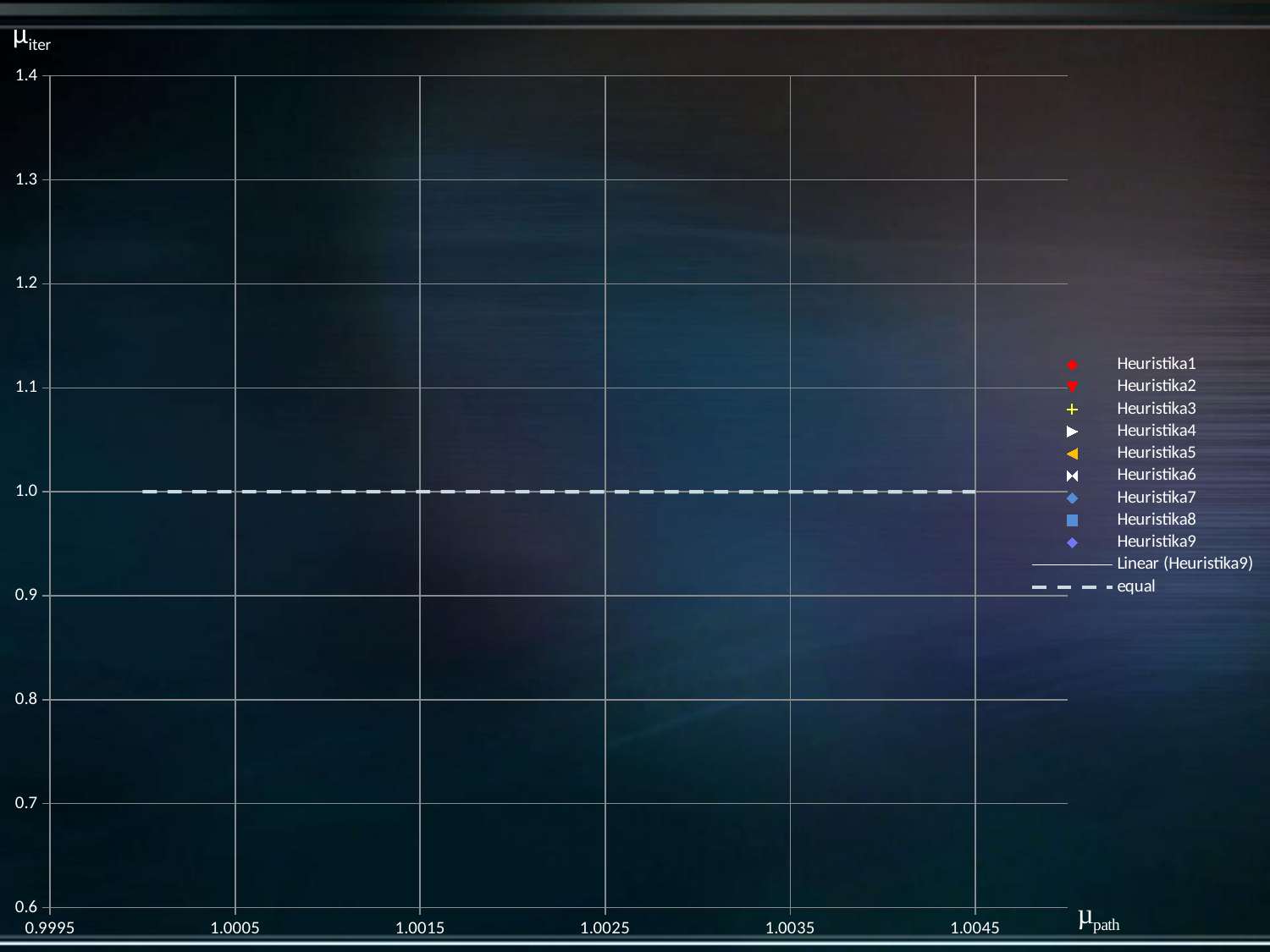
What is the lowest value shown on the y axis? 0.6 What is the label of the horizontal axis? μpath What is the leftmost value shown on the x axis? 0.9995 Is the value of the 'equal' line greater or less than 1.1? less What is the rightmost value shown on the x axis? 1.0045 What is the highest value shown on the y axis? 1.4 At what y-axis value does the dashed 'equal' line lie? 1.0 Is the value of the 'equal' line greater or less than 0.9? greater What is the label of the vertical axis? μiter Does the 'equal' line rise, fall, or stay flat along the x axis? stays flat How many entries does the chart's legend list? 11 What kind of chart is shown on the slide? scatter chart